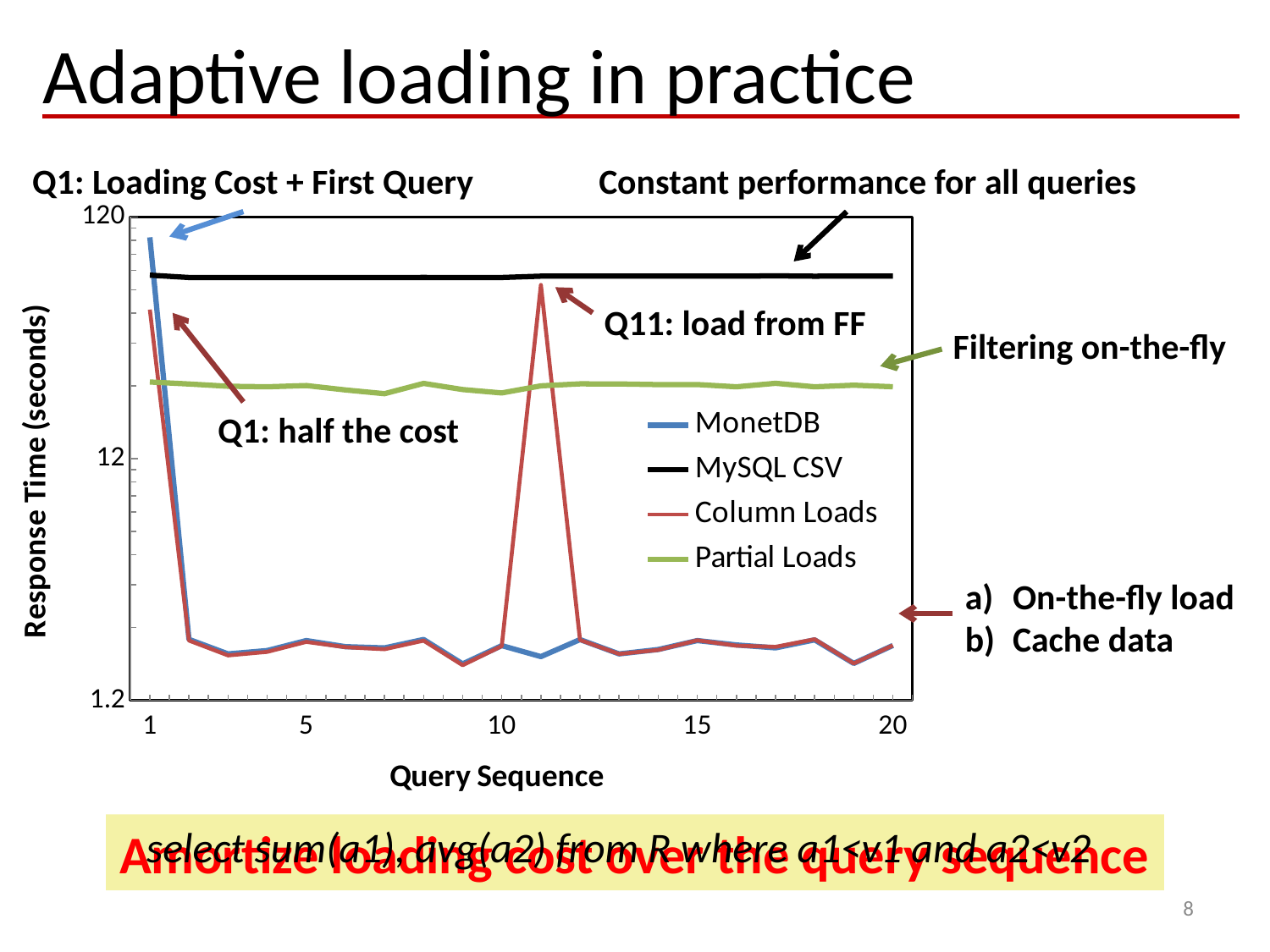
At query 11, which has the larger response time: Column Loads or Partial Loads? Column Loads What is the title of the y axis of the chart? Response Time (seconds) At query 1, which has the larger response time: MonetDB or Column Loads? MonetDB How many series does the chart legend list? 4 What kind of chart is shown on the slide? line chart Is the MySQL CSV response time at query 5 greater or less than 12 seconds? greater Is the MonetDB response time at query 5 greater or less than 12 seconds? less How many queries are shown along the x axis of the chart? 20 Does the MonetDB response time rise or fall from query 1 to query 2? fall Is the Partial Loads response time at query 10 greater or less than 12 seconds? greater Which series has the highest response time at query 15? MySQL CSV